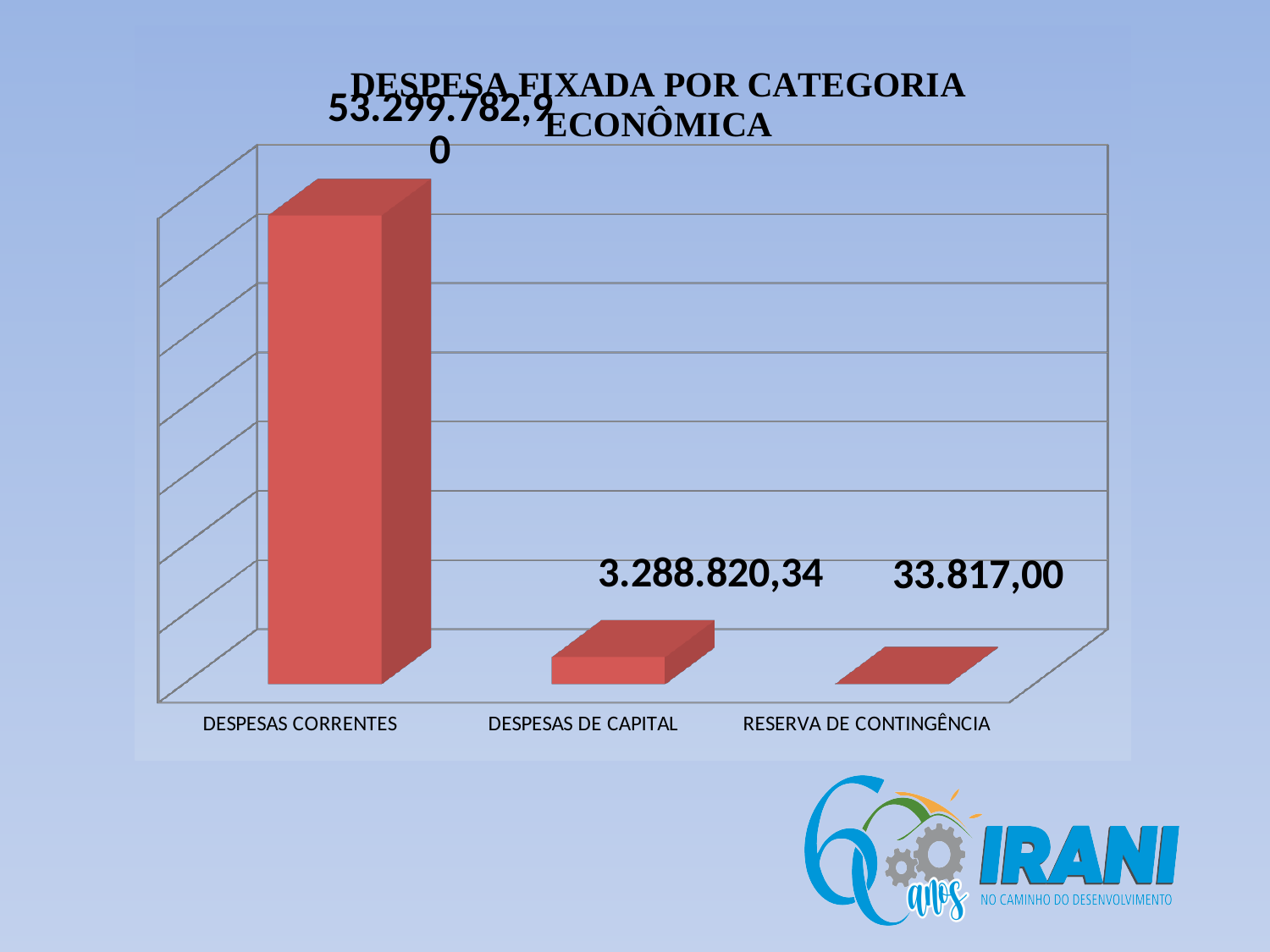
What is the value for RESERVA DE CONTINGÊNCIA? 33.817,00 Which category has the highest value? DESPESAS CORRENTES What is the difference between DESPESAS DE CAPITAL and RESERVA DE CONTINGÊNCIA? 3.255.003,34 Which category has the lowest value? RESERVA DE CONTINGÊNCIA Do the values rise or fall from left to right across the categories? Fall What is the value for DESPESAS DE CAPITAL? 3.288.820,34 What is the title of the chart? DESPESA FIXADA POR CATEGORIA ECONÔMICA How many categories are shown on the chart? 3 What kind of chart is shown on the slide? Bar chart What is the difference between DESPESAS CORRENTES and DESPESAS DE CAPITAL? 50.010.962,56 What is the value for DESPESAS CORRENTES? 53.299.782,90 Which is larger, DESPESAS DE CAPITAL or RESERVA DE CONTINGÊNCIA? DESPESAS DE CAPITAL